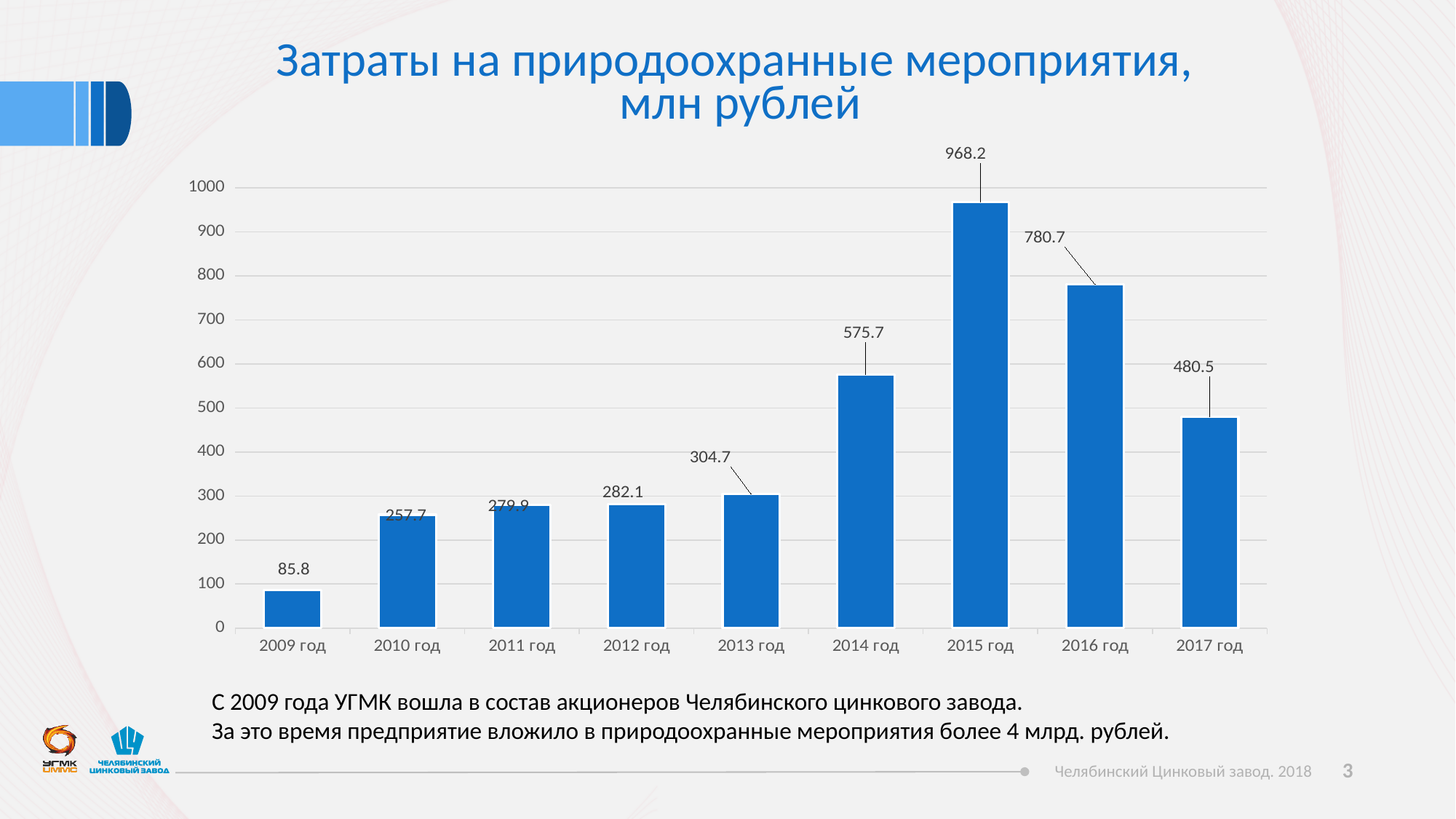
What is the difference between the values for 2015 год and 2016 год? 187.5 Which is larger, the value for 2016 год or the value for 2017 год? 2016 год Do the values rise or fall from 2009 год to 2015 год? rise What is the value for 2015 год? 968.2 What is the value for 2017 год? 480.5 Is the value for 2014 год greater or less than 500? greater How many years are shown on the x axis? 9 What is the value for 2009 год? 85.8 Which year has the highest value? 2015 год What kind of chart is shown on the slide? bar chart Which year has the lowest value? 2009 год What is the difference between the values for 2014 год and 2013 год? 271